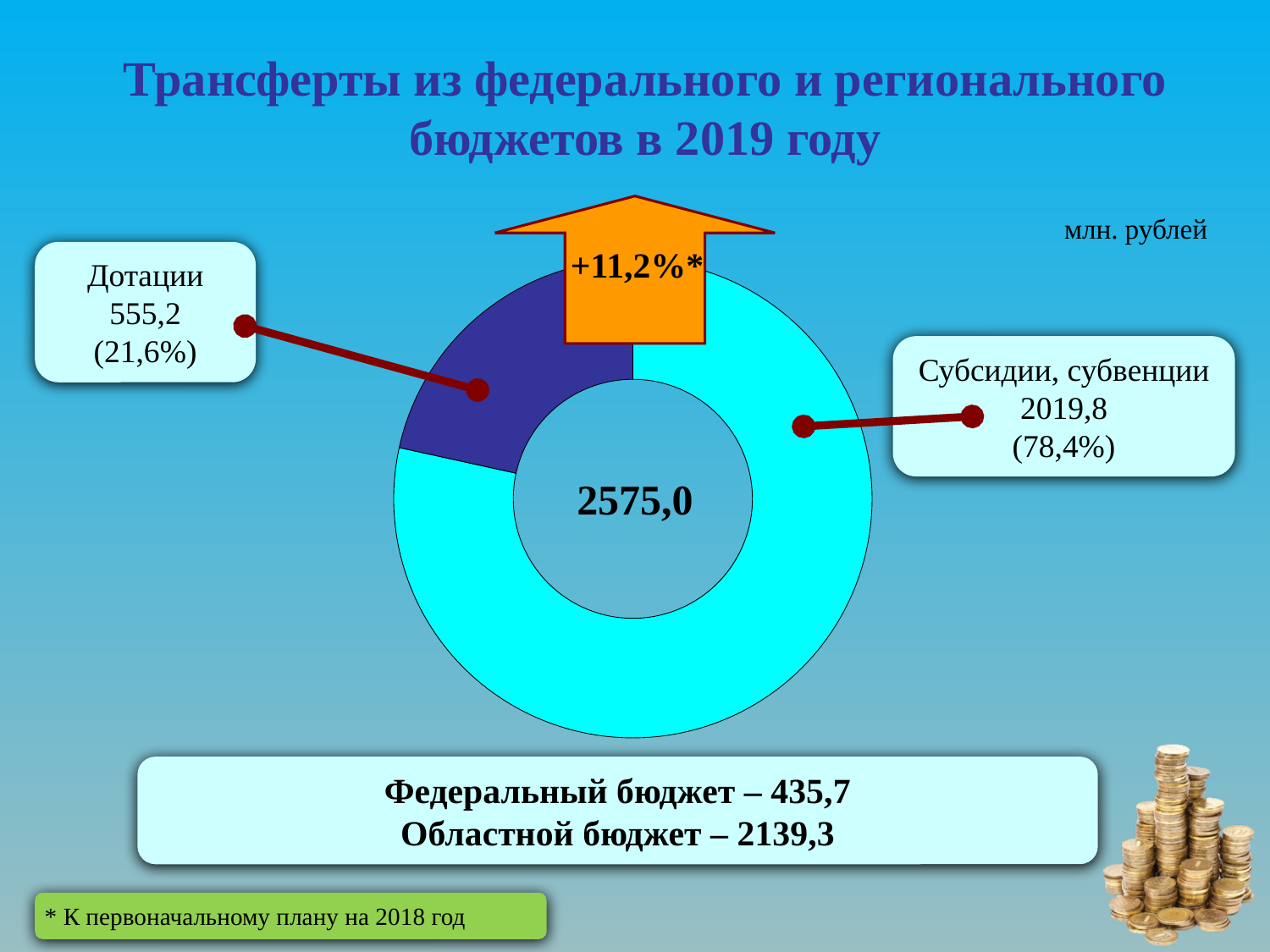
What is the difference between the values for Субсидии, субвенции and Дотации? 1464,6 What total value is printed in the centre of the chart? 2575,0 What unit of measurement is indicated for the chart values? млн. рублей How many categories are shown on the chart? 2 What kind of chart is shown on the slide? Pie (donut) chart What is the value for Дотации on the chart? 555,2 Which category has the largest slice on the chart? Субсидии, субвенции What share of the chart does the Дотации slice represent? 21,6% What is the value for Субсидии, субвенции on the chart? 2019,8 Which category has the smallest slice on the chart? Дотации Which is larger: the value for Дотации or the value for Субсидии, субвенции? Субсидии, субвенции What share of the chart does the Субсидии, субвенции slice represent? 78,4%